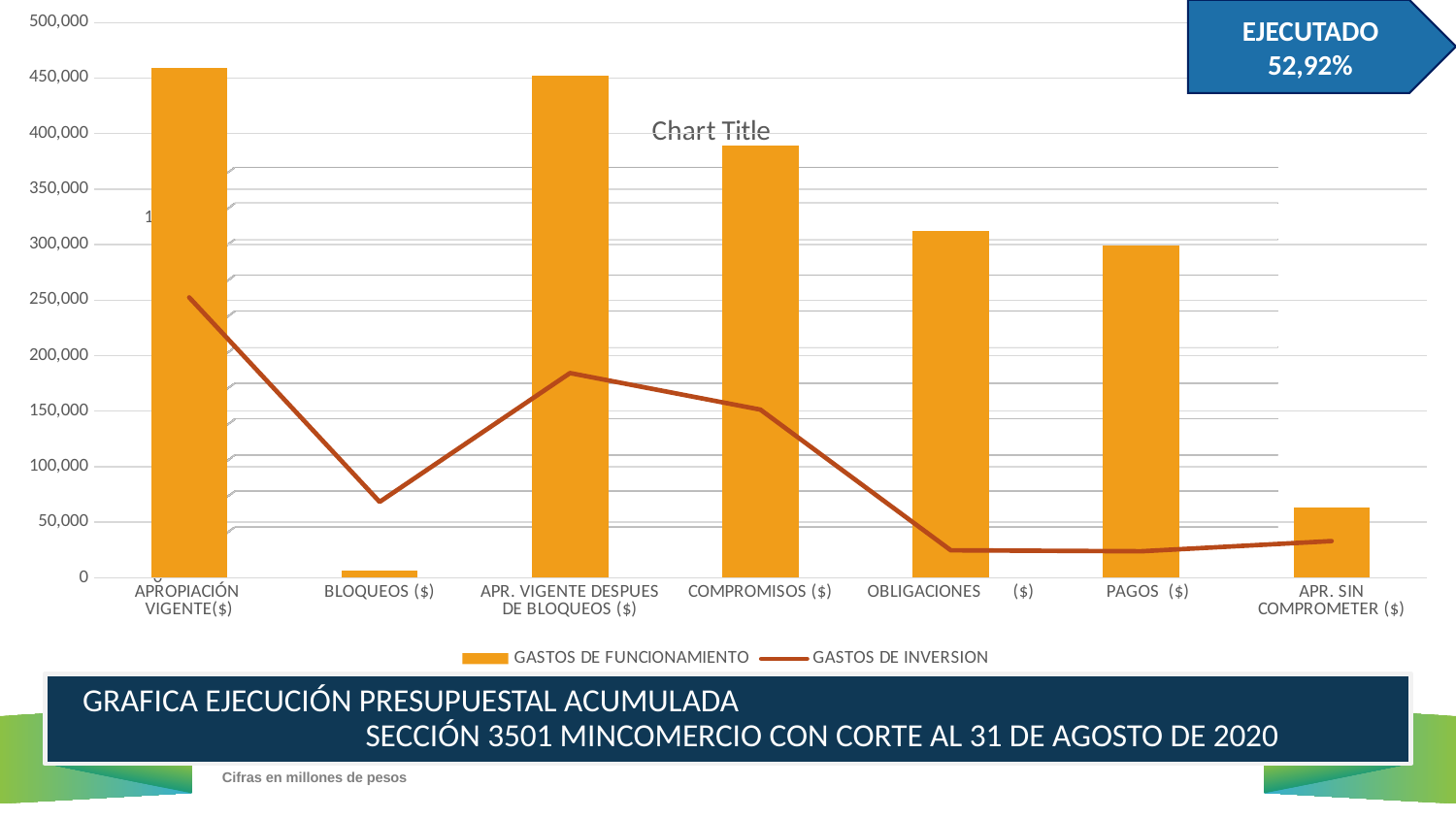
How many categories are shown on the x axis of the chart? 7 What kind of chart is shown on the slide? A combined bar and line chart Is the GASTOS DE FUNCIONAMIENTO value for APR. SIN COMPROMETER ($) greater or less than 100,000? less Is the GASTOS DE FUNCIONAMIENTO value for COMPROMISOS ($) greater or less than 350,000? greater Is the GASTOS DE INVERSION value for BLOQUEOS ($) greater or less than 100,000? less Which is larger for COMPROMISOS ($): GASTOS DE FUNCIONAMIENTO or GASTOS DE INVERSION? GASTOS DE FUNCIONAMIENTO How many series does the chart legend list? 2 At which category does the GASTOS DE INVERSION line reach its highest value? APROPIACIÓN VIGENTE($) Which category has the larger GASTOS DE FUNCIONAMIENTO bar: COMPROMISOS ($) or OBLIGACIONES ($)? COMPROMISOS ($) Which category has the lowest GASTOS DE FUNCIONAMIENTO bar? BLOQUEOS ($) Which series is drawn as a line in the chart? GASTOS DE INVERSION